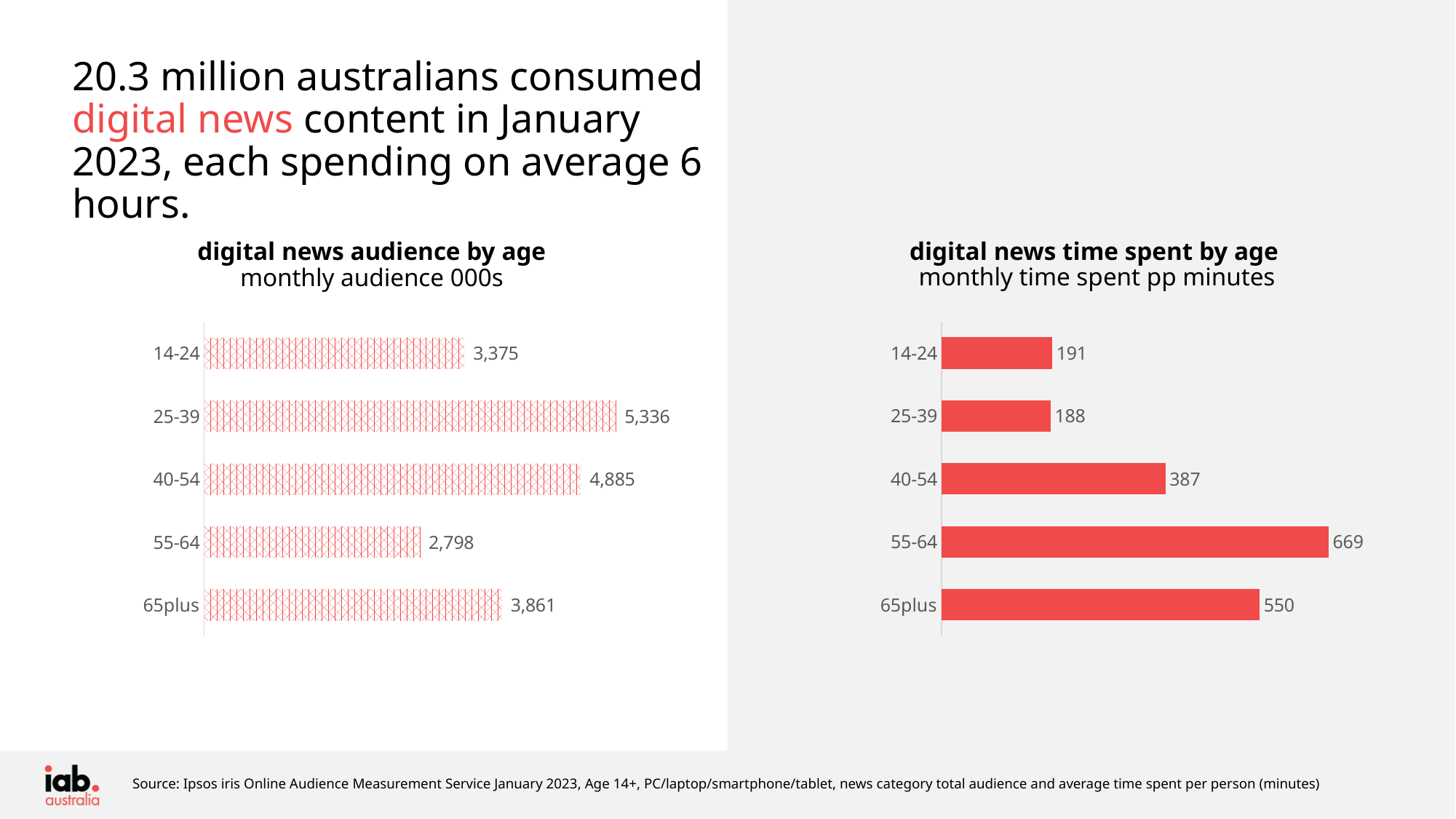
In the 'digital news time spent by age' chart, what is the monthly time spent for the 40-54 age group? 387 What type of chart is the 'digital news time spent by age' chart? Bar chart In the 'digital news time spent by age' chart, which age group spends the least time? 25-39 In the 'digital news audience by age' chart, which age group has the highest monthly audience? 25-39 In the 'digital news time spent by age' chart, which age group spends the most time? 55-64 In the 'digital news audience by age' chart, what is the monthly audience for the 25-39 age group? 5,336 In the 'digital news audience by age' chart, what is the difference between the 40-54 and 14-24 audiences? 1,510 In the 'digital news time spent by age' chart, what is the difference in minutes between the 55-64 and 65plus groups? 119 In the 'digital news time spent by age' chart, which group spends more time, 14-24 or 40-54? 40-54 What is the subtitle of the 'digital news audience by age' chart? monthly audience 000s In the 'digital news audience by age' chart, which age group has the lowest monthly audience? 55-64 In the 'digital news audience by age' chart, how many age groups are shown? 5